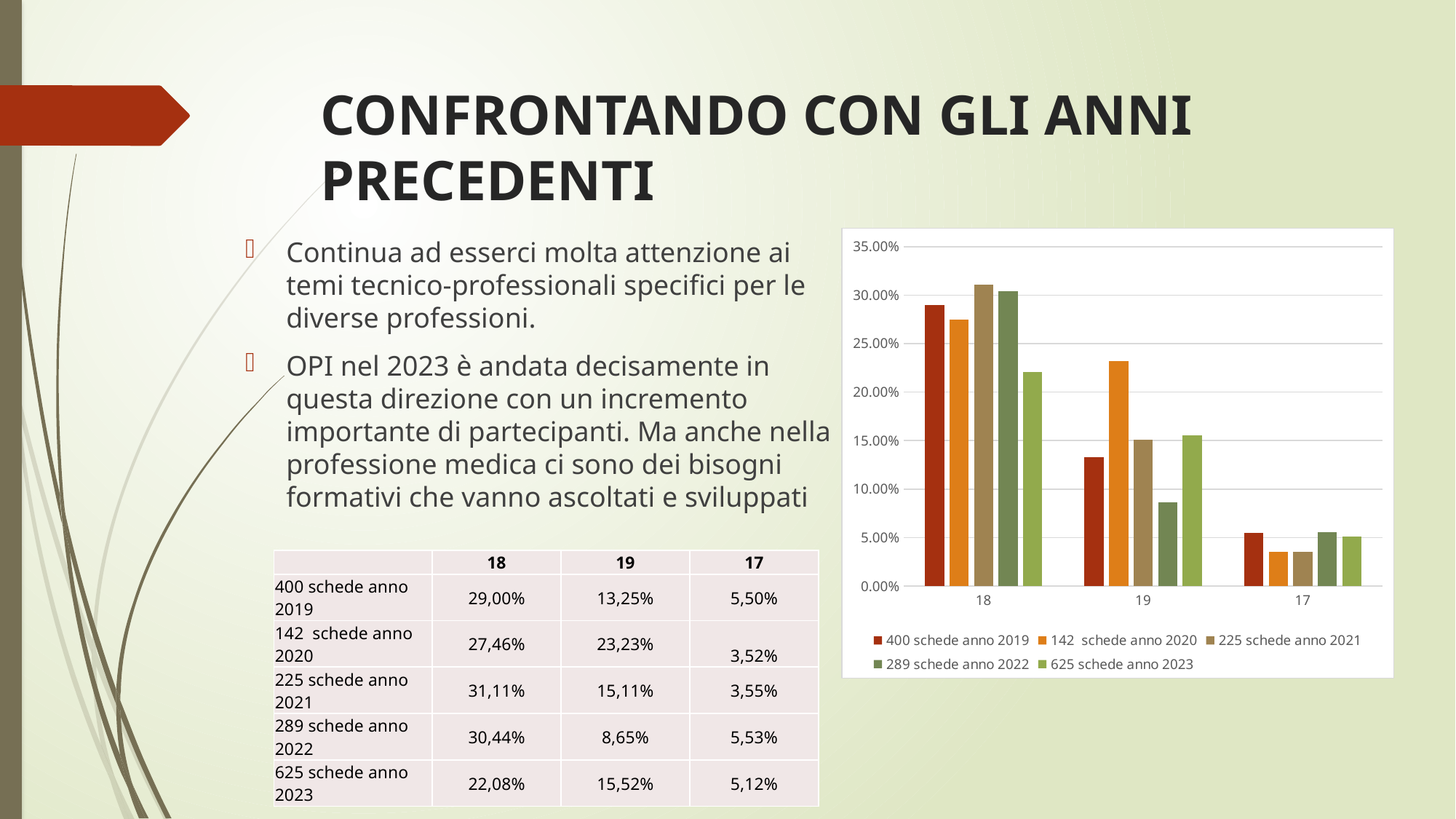
How many categories are shown on the x axis of the chart? 3 In category 19, which series has the highest bar? 142 schede anno 2020 What is the difference between the values for 400 schede anno 2019 in category 18 and in category 19? 15,75% What is the value for 625 schede anno 2023 in category 19? 15,52% Which series is drawn in dark red in the chart? 400 schede anno 2019 In category 17, which is larger: 400 schede anno 2019 or 142 schede anno 2020? 400 schede anno 2019 In category 19, which series has the lowest bar? 289 schede anno 2022 Is the value for 142 schede anno 2020 in category 19 greater or less than 20.00%? greater Do the values for 400 schede anno 2019 rise or fall across the categories 18, 19, 17? fall Is the value for 625 schede anno 2023 in category 18 greater or less than 25.00%? less What kind of chart is shown on the slide? bar chart How many series does the chart legend list? 5